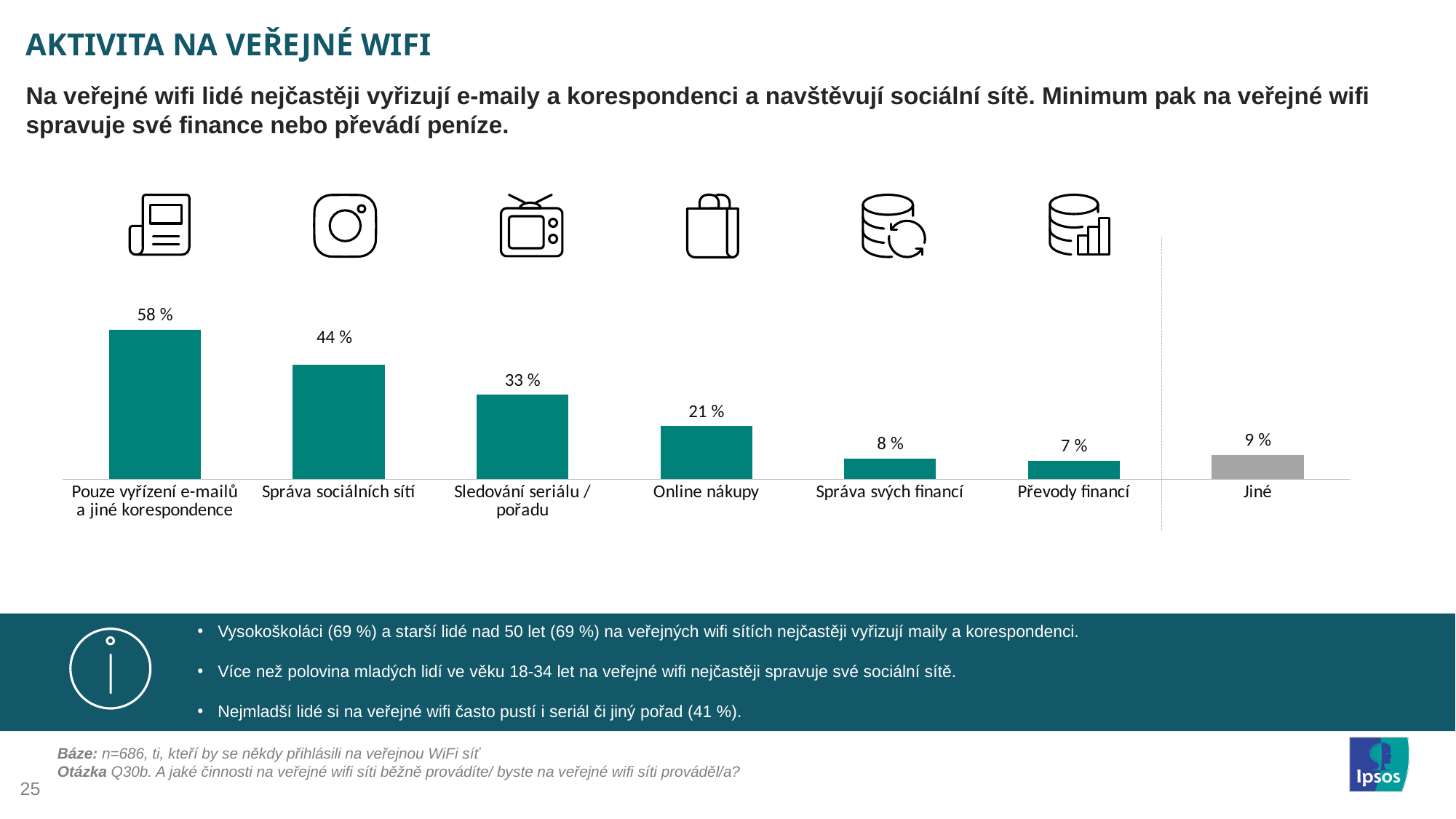
What is the value for Správa sociálních sítí? 44 % Which category has the lowest value? Převody financí Which category has the highest value? Pouze vyřízení e-mailů a jiné korespondence What is the difference between the values for Pouze vyřízení e-mailů a jiné korespondence and Správa sociálních sítí? 14 % What kind of chart is shown on the slide? Bar chart Which is larger, the value for Správa svých financí or the value for Jiné? Jiné How many categories are shown in the chart? 7 What is the value for Převody financí? 7 % What is the value for Jiné? 9 % What is the value for Online nákupy? 21 % Which bar is shown in a different colour (grey) from the others? Jiné What is the difference between the values for Sledování seriálu / pořadu and Online nákupy? 12 %